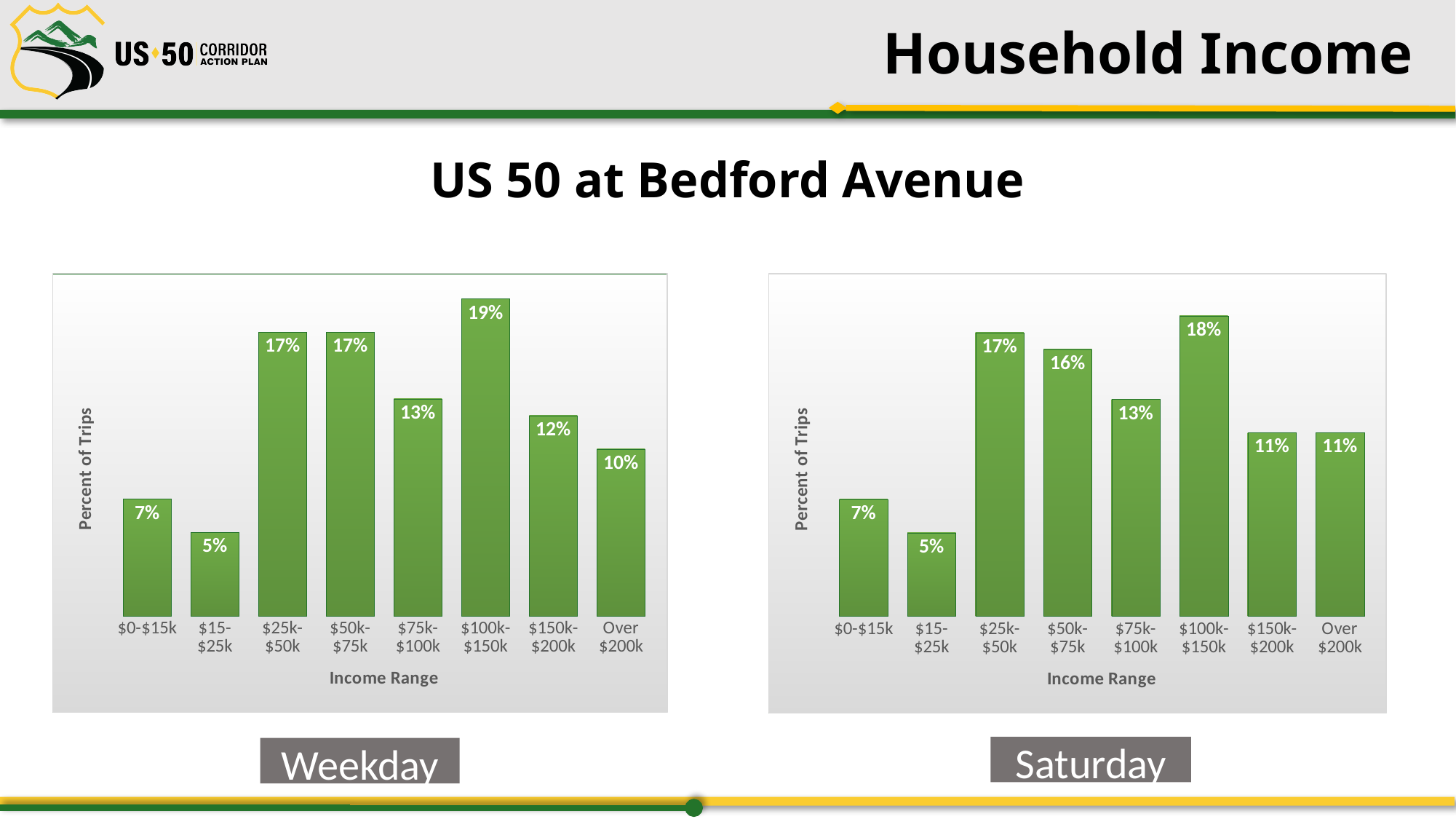
What kind of chart is the Saturday chart? Bar chart How many income range categories are shown in the Weekday chart? 8 In the Saturday chart, what is the difference between the $100k-$150k value and the $150k-$200k value? 7% What is the y-axis title of the Saturday chart? Percent of Trips In the Saturday chart, which income range has the lowest percent of trips? $15-$25k In the Weekday chart, what percent of trips are in the $15-$25k income range? 5% In the Saturday chart, what percent of trips are in the $50k-$75k income range? 16% What is the x-axis title of the Weekday chart? Income Range In the Weekday chart, what is the difference between the $100k-$150k value and the Over $200k value? 9% In the Saturday chart, which is larger: the value for $25k-$50k or the value for $100k-$150k? $100k-$150k In the Weekday chart, which income range has the highest percent of trips? $100k-$150k In the Weekday chart, what percent of trips are in the $100k-$150k income range? 19%